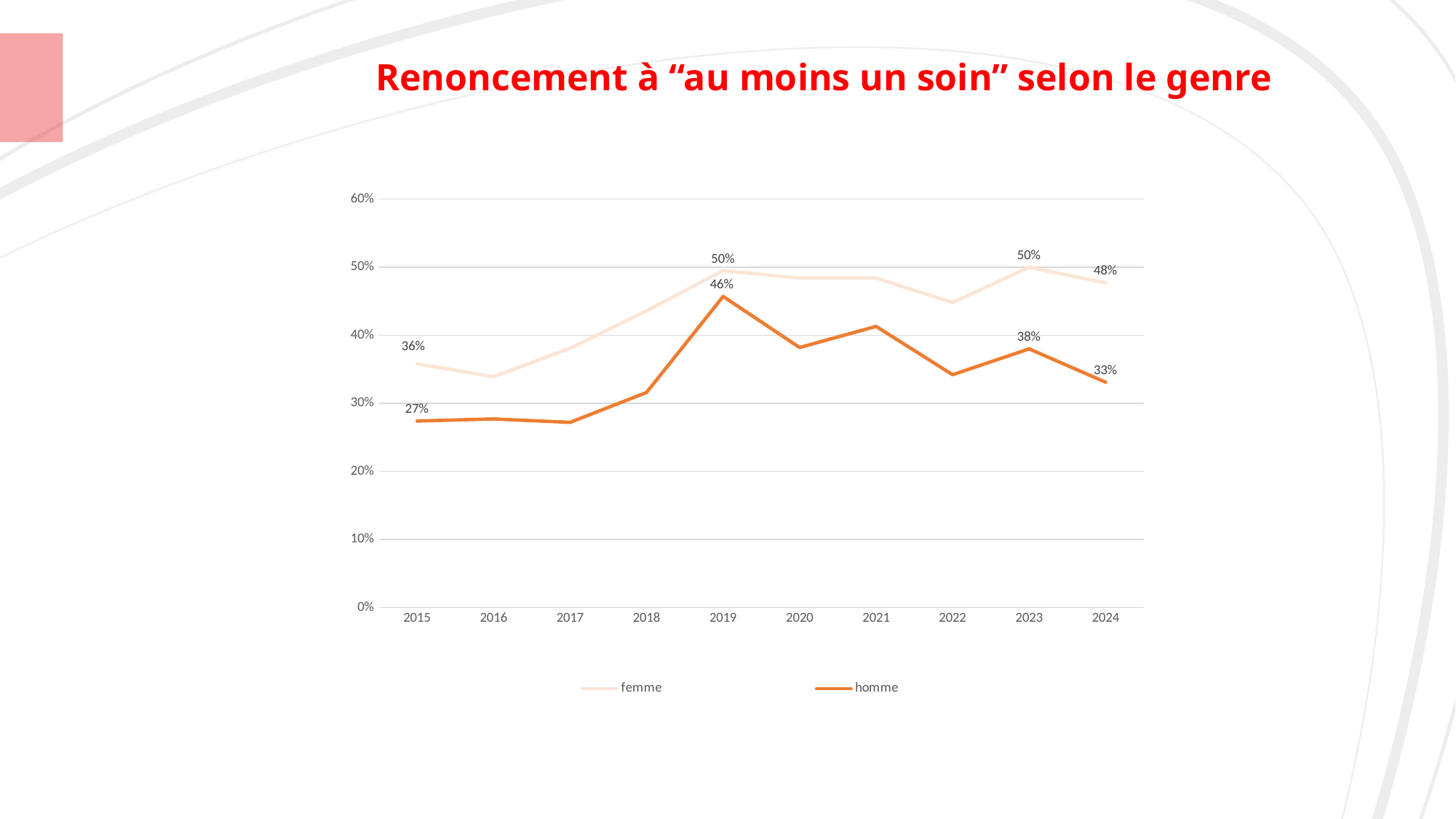
Which series has the higher value in 2023, femme or homme? femme What is the value for femme in 2015? 36% What is the difference between the femme and homme values in 2024? 15% How many series does the legend list? 2 What is the value for femme in 2024? 48% Is the value for homme in 2020 greater or less than 30%? greater What is the value for homme in 2024? 33% What type of chart is shown on the slide? line chart What is the value for homme in 2019? 46% What is the title of the chart? Renoncement à “au moins un soin” selon le genre How many years are shown on the x axis? 10 What is the difference between the femme and homme values in 2015? 9%